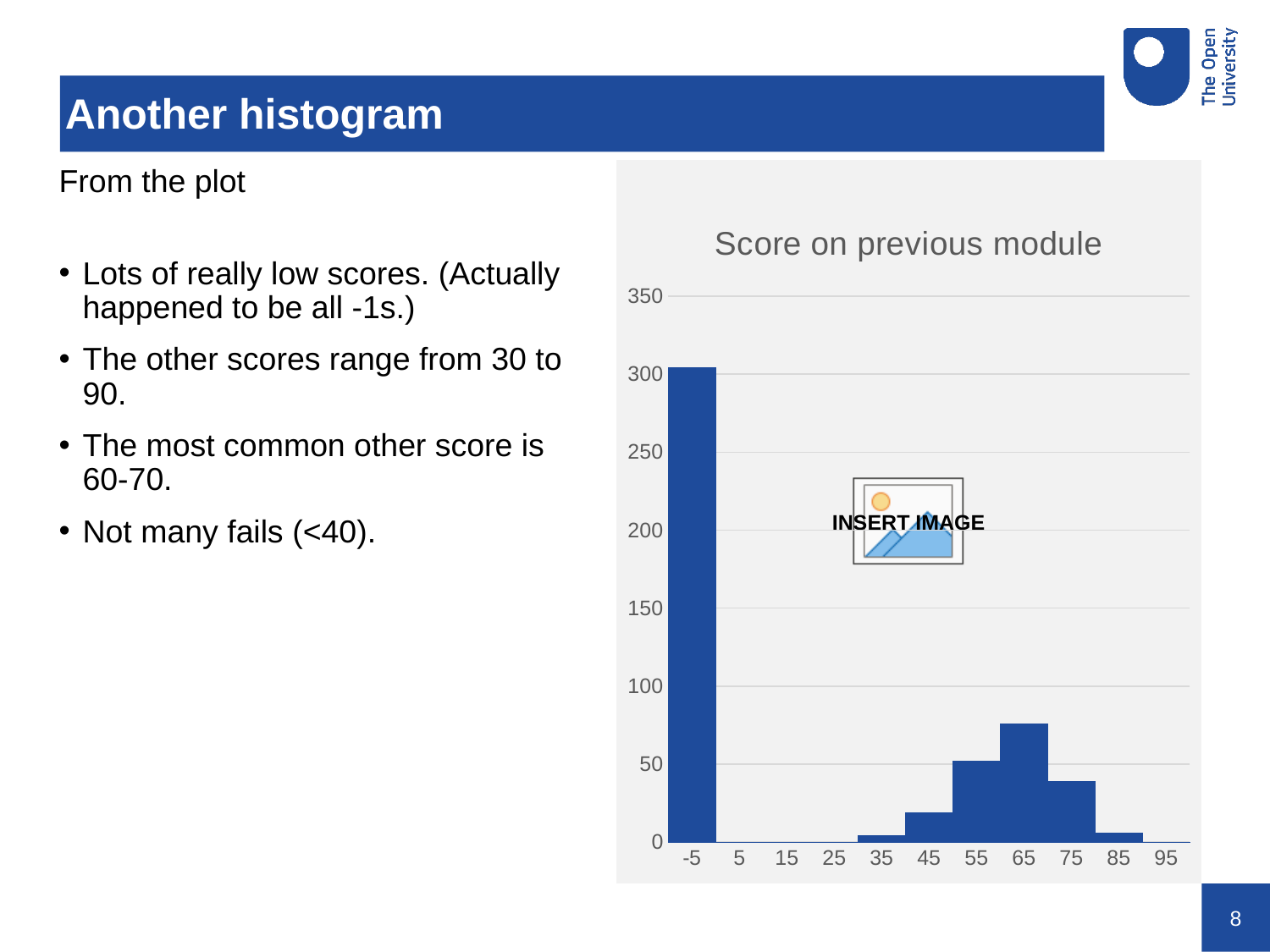
What kind of chart is shown on the slide? bar chart Is the value for the 65 bar greater or less than 100? less Is the value for the 65 bar greater or less than 50? greater Is the value for the -5 bar greater or less than 250? greater Which bar is taller, the one at 55 or the one at 75? 55 What is the title of the chart? Score on previous module Which x-axis category has the tallest bar? -5 How many tick labels are shown on the x axis? 11 Do the bar heights rise or fall going from 65 to 85 along the x axis? fall Which bar is taller, the one at 65 or the one at 55? 65